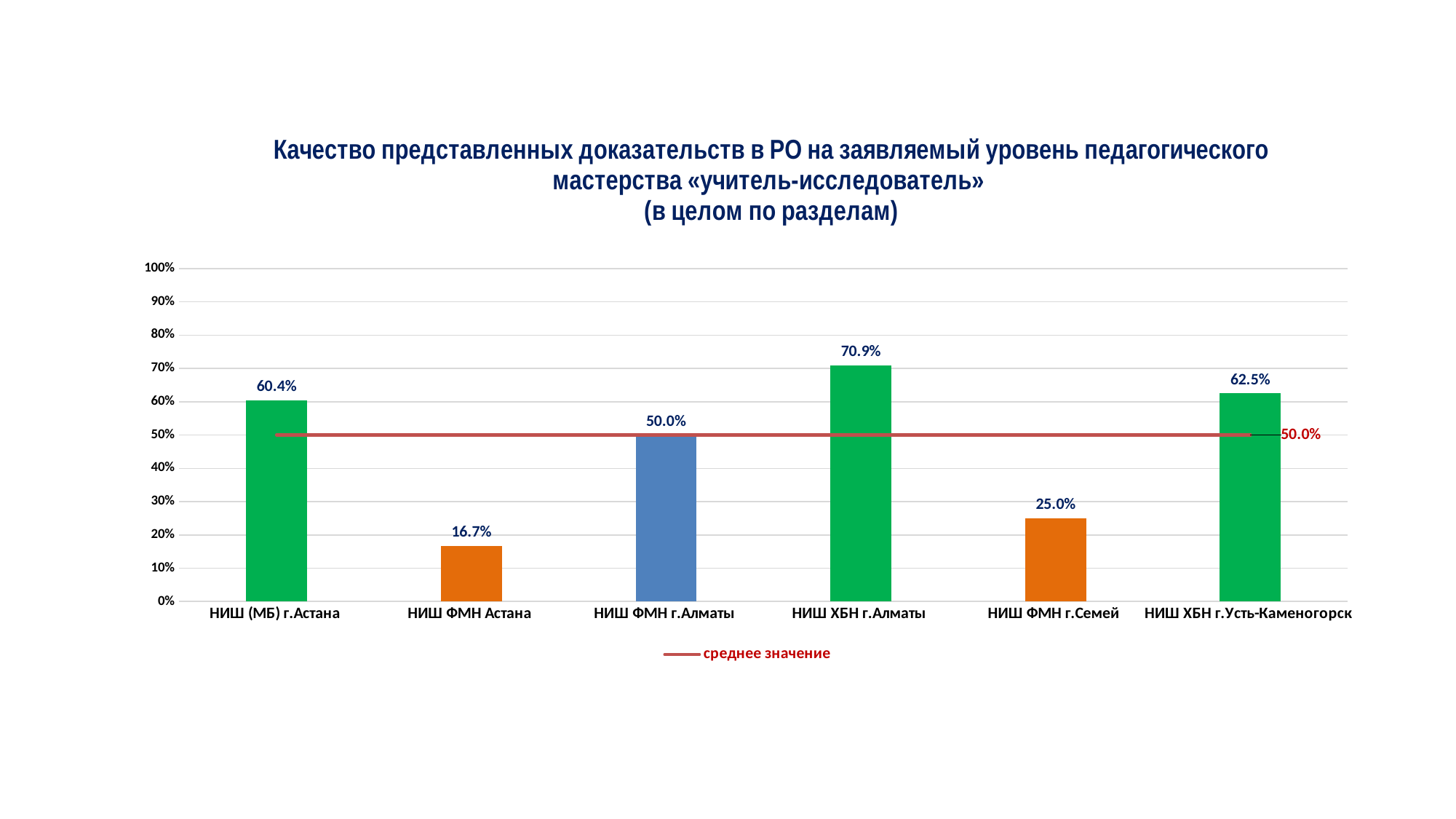
What does the legend say the red line represents? среднее значение What value is labelled on the red horizontal line? 50.0% What is the value for НИШ ХБН г.Усть-Каменогорск? 62.5% What kind of chart is this? bar chart What is the value for НИШ (МБ) г.Астана? 60.4% Is the value for НИШ ФМН г.Семей greater or less than 30%? less Which category has the lowest value? НИШ ФМН Астана Which is larger, the value for НИШ (МБ) г.Астана or the value for НИШ ХБН г.Усть-Каменогорск? НИШ ХБН г.Усть-Каменогорск What is the difference between the values for НИШ ХБН г.Алматы and НИШ ФМН г.Семей? 45.9% What is the value for НИШ ФМН Астана? 16.7% How many categories are shown on the x axis? 6 Which category has the highest value? НИШ ХБН г.Алматы